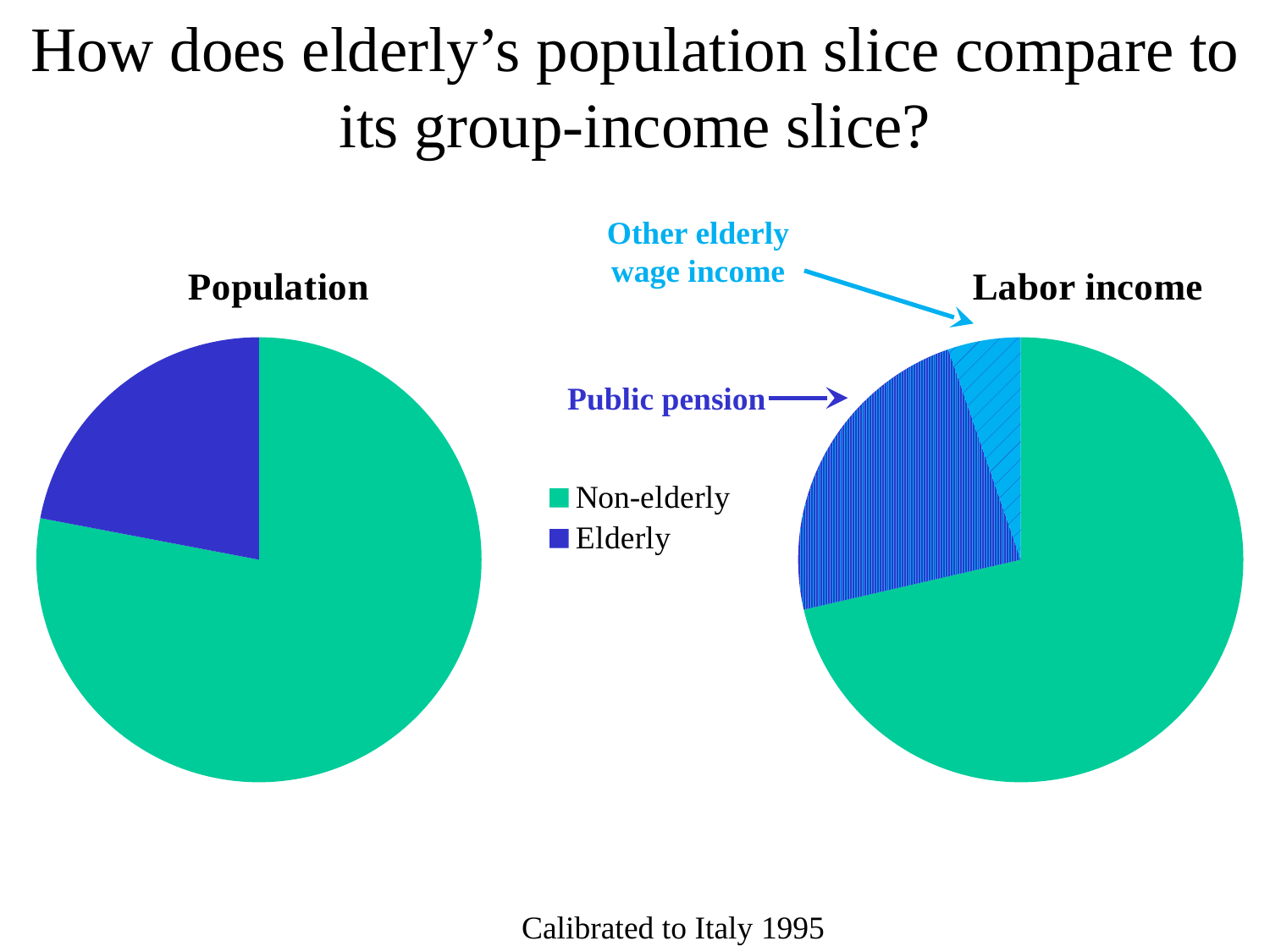
What are the two parts into which the elderly slice of the Labor income chart is divided? Public pension and Other elderly wage income According to the note at the bottom of the slide, what country and year are the charts calibrated to? Italy 1995 How many slices does the Population chart have? 2 How many entries does the legend list? 2 How many slices does the Labor income chart have? 3 What kind of chart is the Labor income chart? pie chart In the Labor income chart, which is larger, the Public pension slice or the Other elderly wage income slice? Public pension In the Population chart, which category has the largest slice? Non-elderly What kind of chart is the Population chart? pie chart In the Population chart, which category has the smallest slice? Elderly In the Labor income chart, which category has the largest slice? Non-elderly In the Population chart, which is larger, the Non-elderly slice or the Elderly slice? Non-elderly